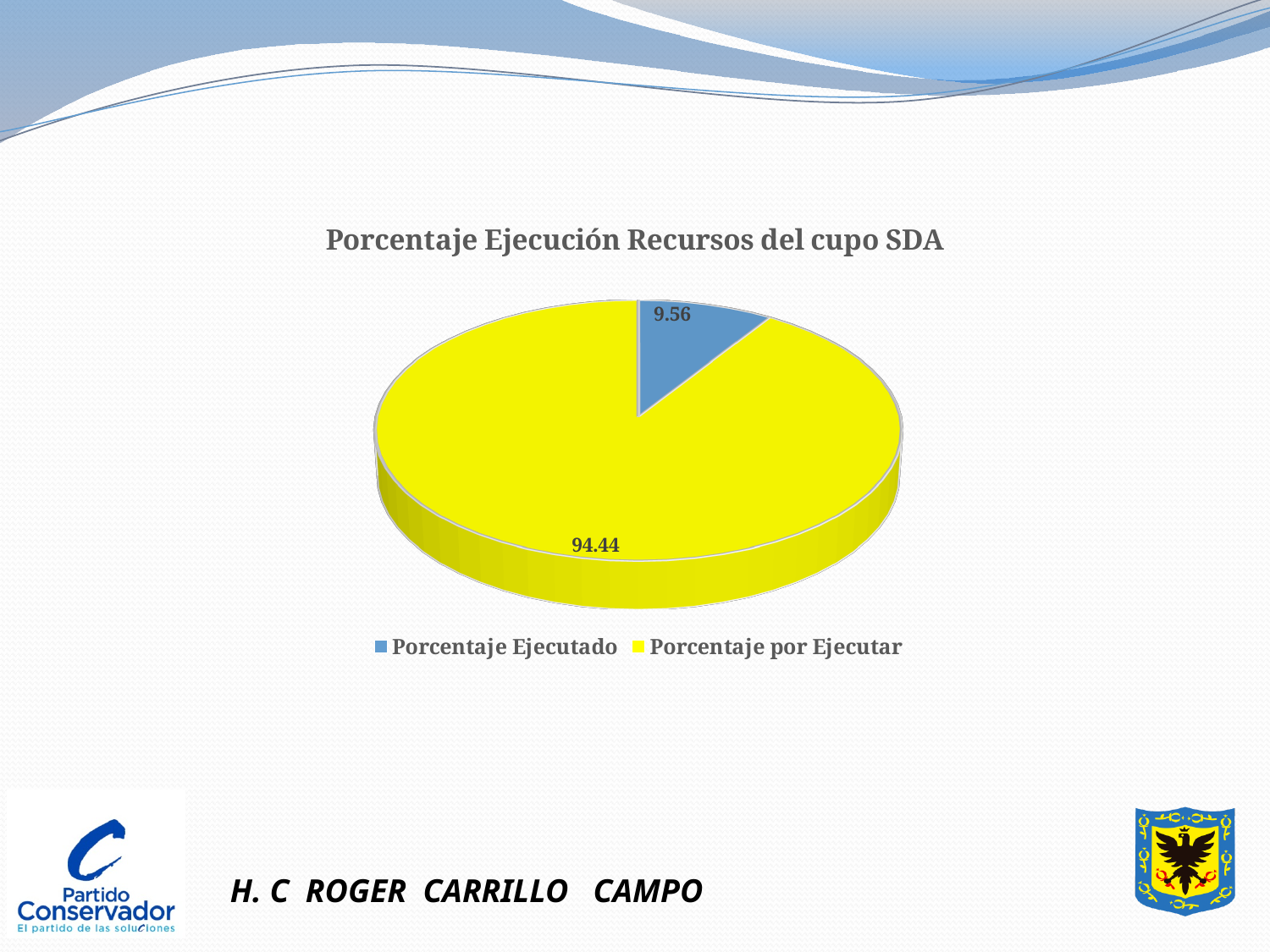
How many entries does the legend list? 2 What is the value for Porcentaje por Ejecutar? 94.44 Which slice is the smallest? Porcentaje Ejecutado How many slices does the pie chart have? 2 What is the value for Porcentaje Ejecutado? 9.56 Which slice is the largest? Porcentaje por Ejecutar Which is larger, Porcentaje Ejecutado or Porcentaje por Ejecutar? Porcentaje por Ejecutar What is the difference between Porcentaje por Ejecutar and Porcentaje Ejecutado? 84.88 What kind of chart is shown on the slide? Pie chart What colour is the Porcentaje por Ejecutar slice? Yellow What is the title of the chart? Porcentaje Ejecución Recursos del cupo SDA